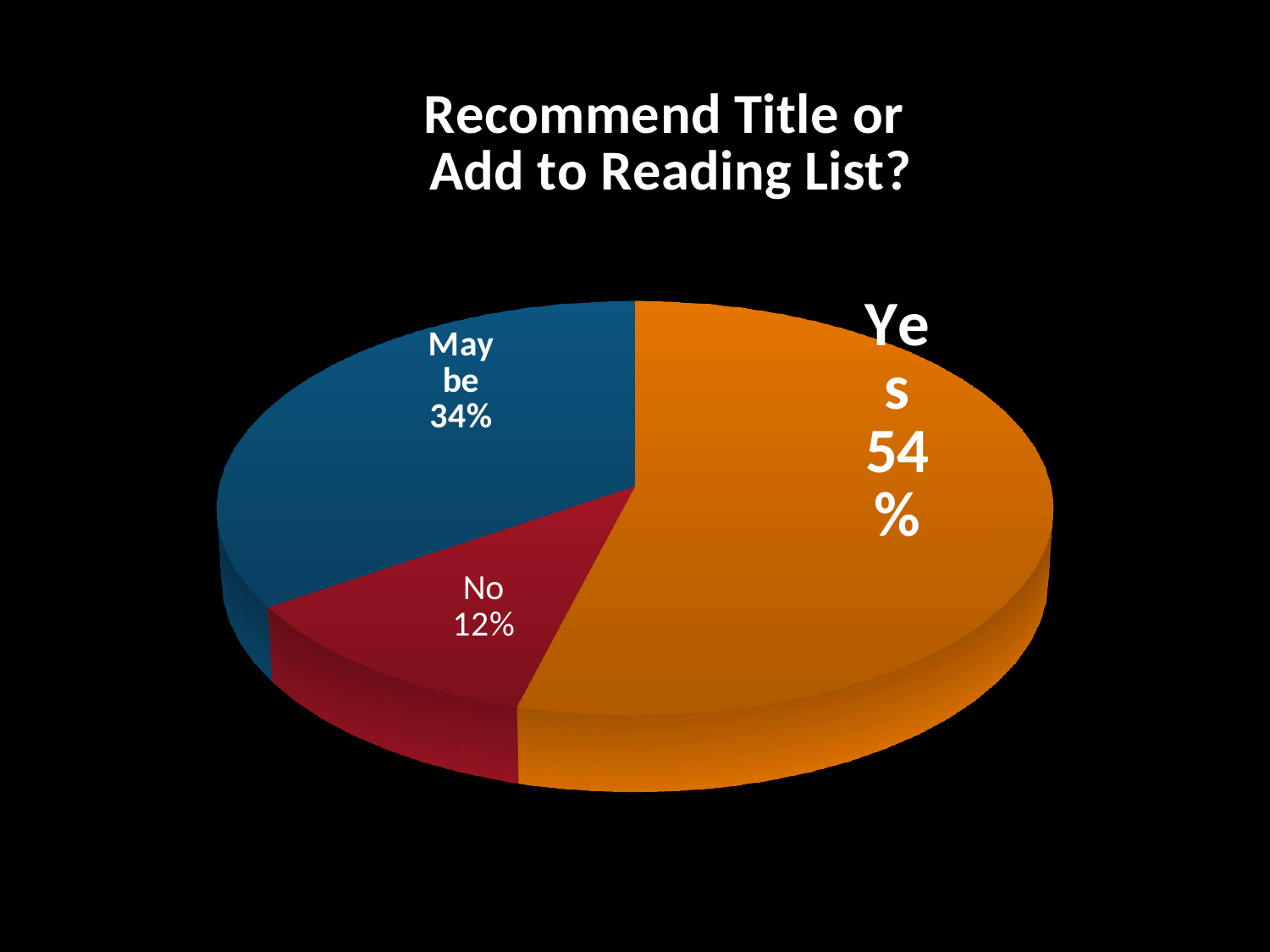
What percentage of responses are "No"? 12% Which is larger, the share for "Maybe" or the share for "No"? Maybe What is the difference in percentage points between "Yes" and "Maybe"? 20 Which response has the smallest share of the pie? No What is the title of the chart? Recommend Title or Add to Reading List? What percentage of responses are "Yes"? 54% What colour is the "No" slice? Red What kind of chart is shown on the slide? Pie chart What percentage of responses are "Maybe"? 34% What is the difference in percentage points between "Maybe" and "No"? 22 How many slices does the pie chart have? 3 Which response has the largest share of the pie? Yes